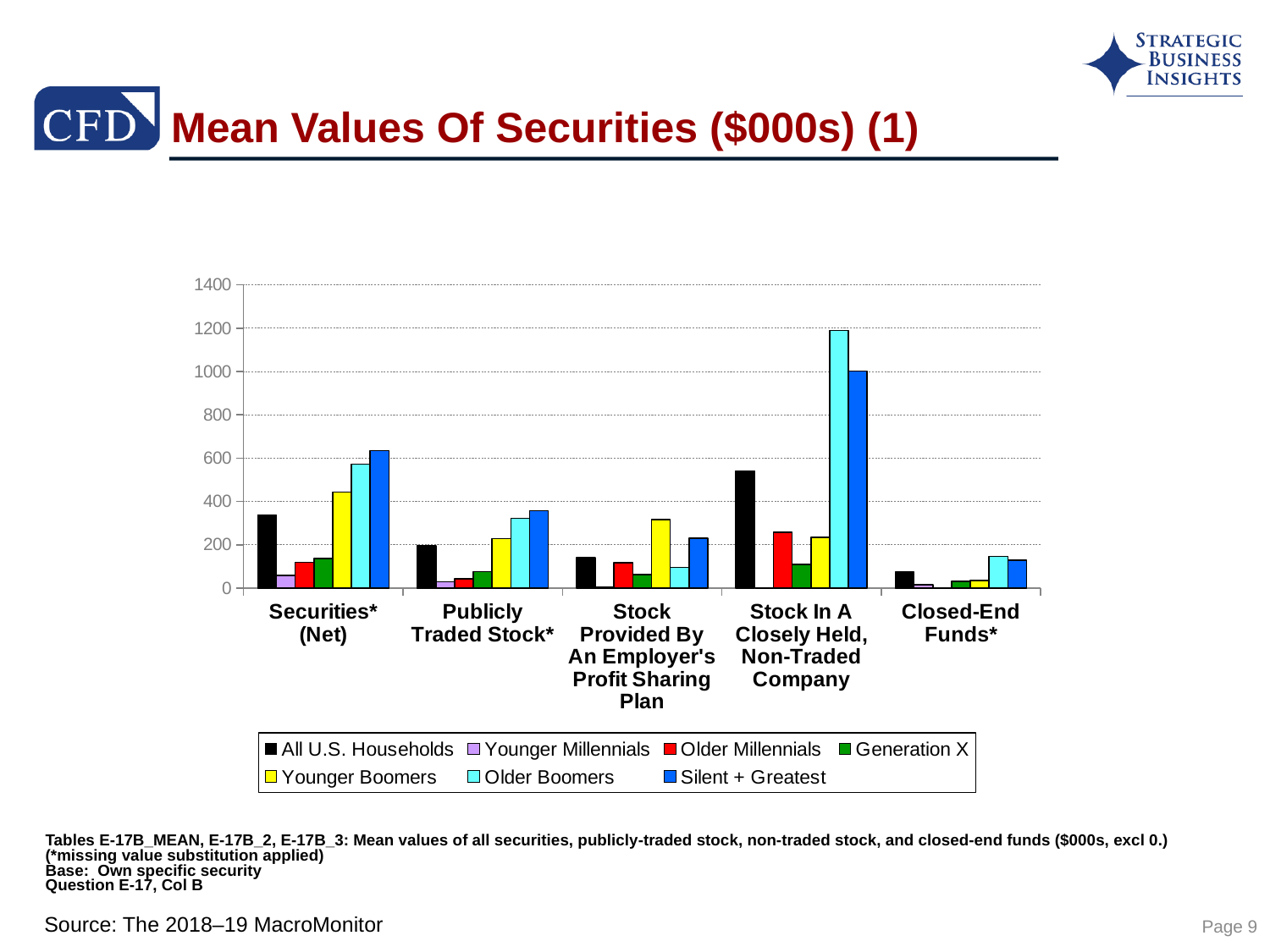
For Stock Provided By An Employer's Profit Sharing Plan, which is larger: the Younger Boomers value or the Silent + Greatest value? Younger Boomers Within the Stock In A Closely Held, Non-Traded Company category, which series has the lowest value? Younger Millennials What kind of chart is shown on the slide? Bar chart Is the Silent + Greatest value for Publicly Traded Stock* greater or less than 400? less For which category is the Older Boomers bar the highest? Stock In A Closely Held, Non-Traded Company What is the title of the chart on the slide? Mean Values Of Securities ($000s) (1) Is the All U.S. Households value for Securities* (Net) greater or less than 200? greater How many security categories are shown along the x axis? 5 Within the Securities* (Net) category, which series has the highest value? Silent + Greatest Is the Older Boomers value for Stock In A Closely Held, Non-Traded Company greater or less than 1000? greater For Securities* (Net), which is larger: the Silent + Greatest value or the Younger Boomers value? Silent + Greatest How many series does the legend list? 7